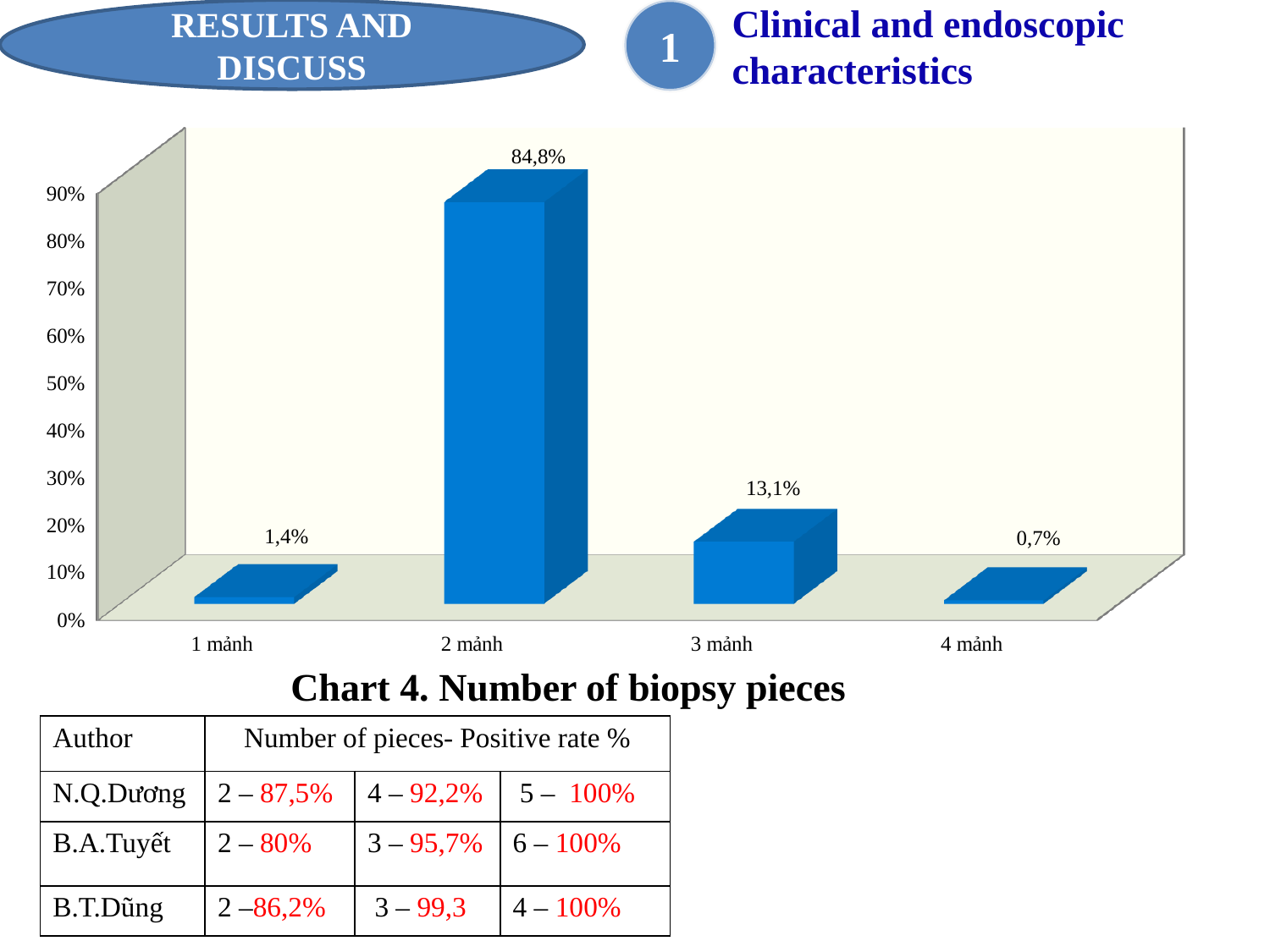
What is the title of the chart on the slide? Chart 4. Number of biopsy pieces How many categories are shown in Chart 4? 4 Which category has the highest value in Chart 4? 2 mảnh What kind of chart is Chart 4? bar chart Which is larger in Chart 4, the value for 1 mảnh or the value for 3 mảnh? 3 mảnh Which category has the lowest value in Chart 4? 4 mảnh What is the difference between the values for 2 mảnh and 3 mảnh in Chart 4? 71,7% What is the value for 2 mảnh in Chart 4? 84,8% Is the value for 2 mảnh in Chart 4 greater or less than 80%? greater What is the value for 3 mảnh in Chart 4? 13,1% What is the value for 4 mảnh in Chart 4? 0,7% What is the value for 1 mảnh in Chart 4? 1,4%